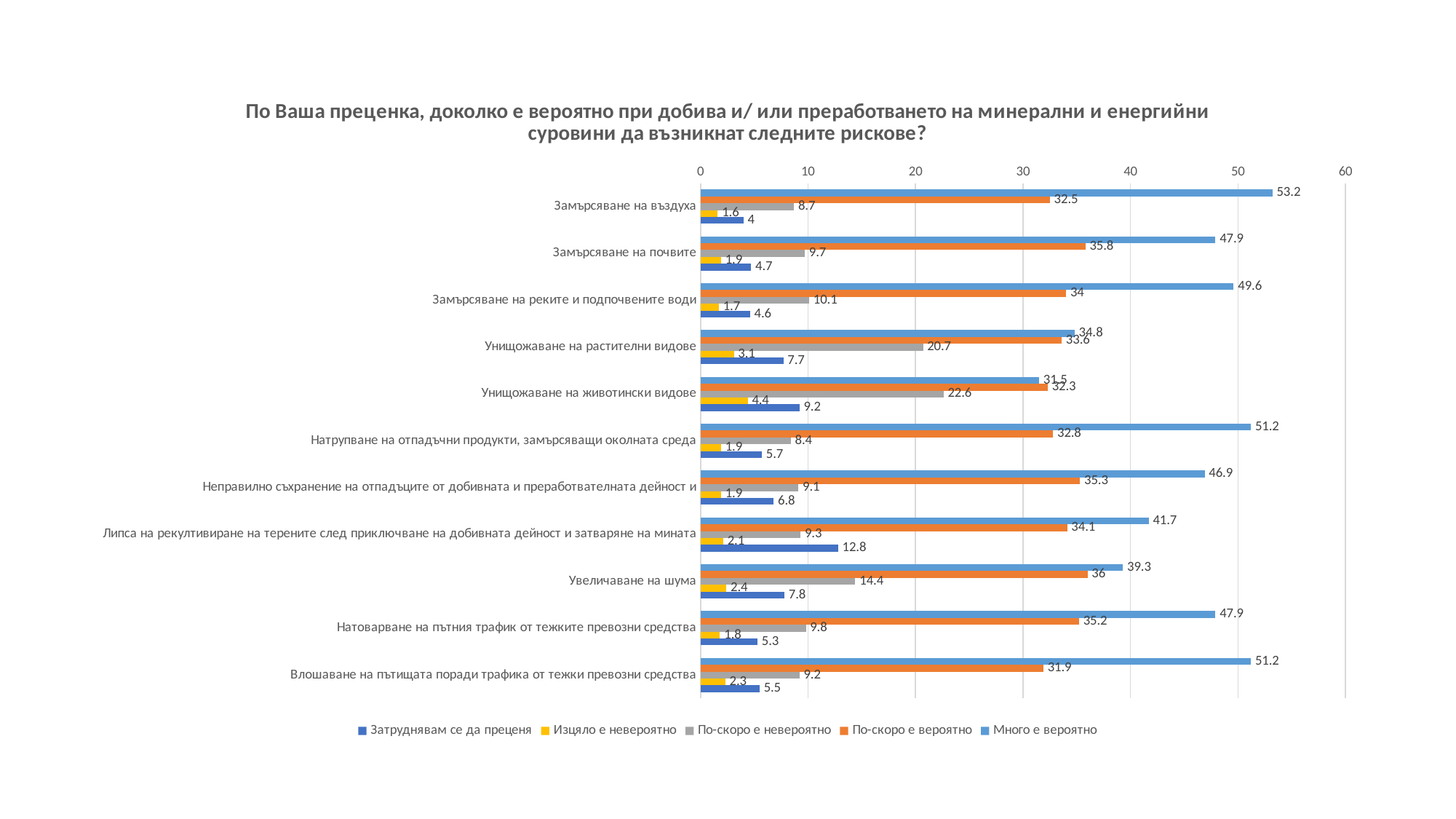
Which category has the highest value for "Много е вероятно"? Замърсяване на въздуха Which category has the highest value for "Изцяло е невероятно"? Унищожаване на животински видове What kind of chart is shown on the slide? bar chart What is the difference between the "Много е вероятно" values for "Замърсяване на въздуха" and "Замърсяване на почвите"? 5.3 How many series does the legend list? 5 Which is larger: the "По-скоро е вероятно" value for "Увеличаване на шума" or for "Влошаване на пътищата поради трафика от тежки превозни средства"? Увеличаване на шума Which category has the lowest value for "Много е вероятно"? Унищожаване на животински видове What is the value of "По-скоро е невероятно" for "Унищожаване на животински видове"? 22.6 How many categories (risks) are plotted on the chart? 11 What is the value of "Затруднявам се да преценя" for "Липса на рекултивиране на терените след приключване на добивната дейност и затваряне на мината"? 12.8 What is the value of "Много е вероятно" for "Замърсяване на въздуха"? 53.2 Which series is shown in orange in the legend? По-скоро е вероятно